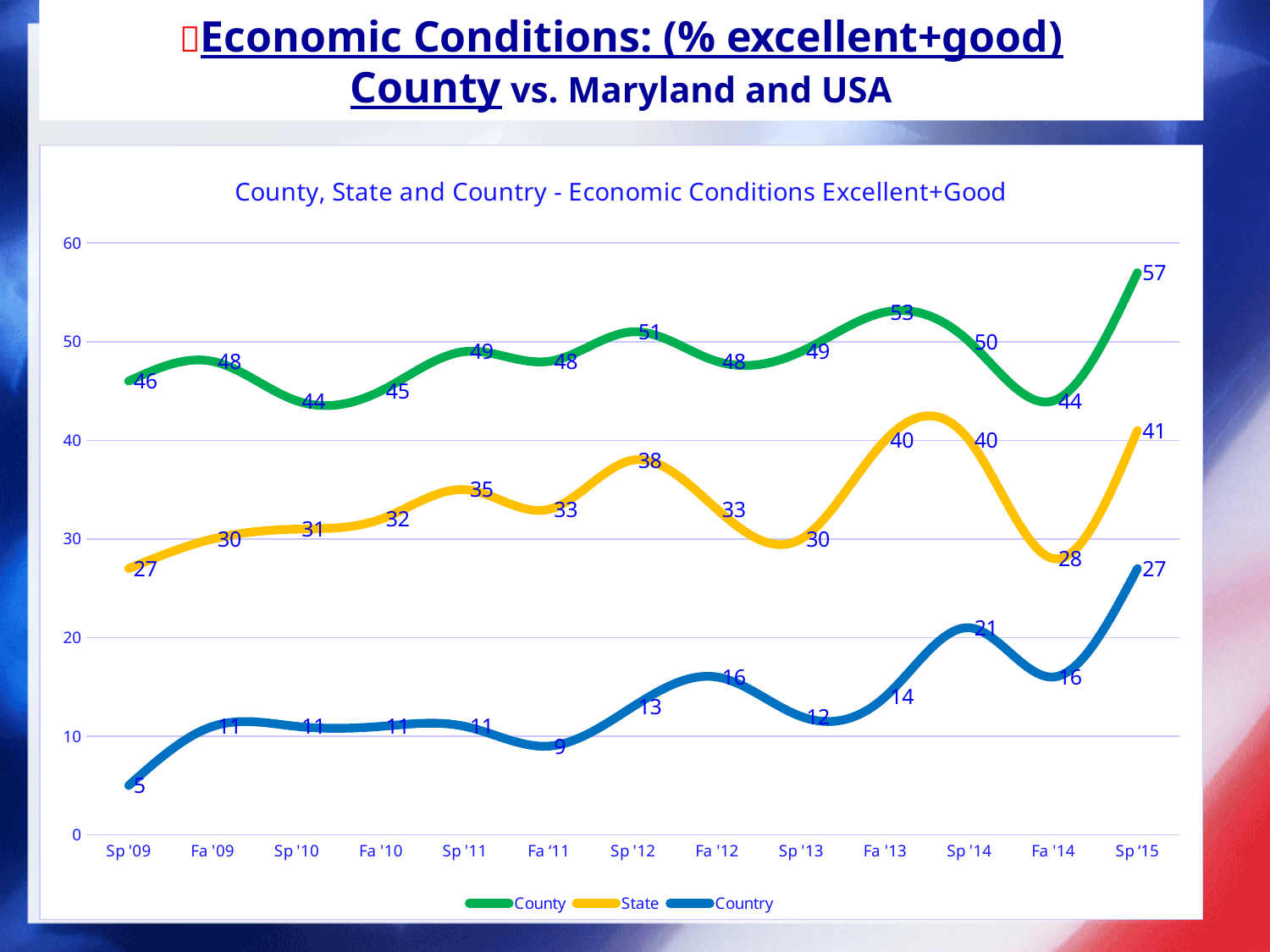
Does the State series rise or fall from Sp '09 to Sp '11? rise At which period is the County series highest? Sp '15 What is the State value at Sp '12? 38 What kind of chart is shown? line chart Which is larger for the State series: the value at Fa '13 or at Fa '14? Fa '13 At which period is the Country series lowest? Sp '09 What colour is the State line? yellow What is the County value at Sp '15? 57 What is the Country value at Fa '11? 9 How many periods are shown on the x axis? 13 What is the difference between the County and State values at Sp '15? 16 How many series does the legend list? 3